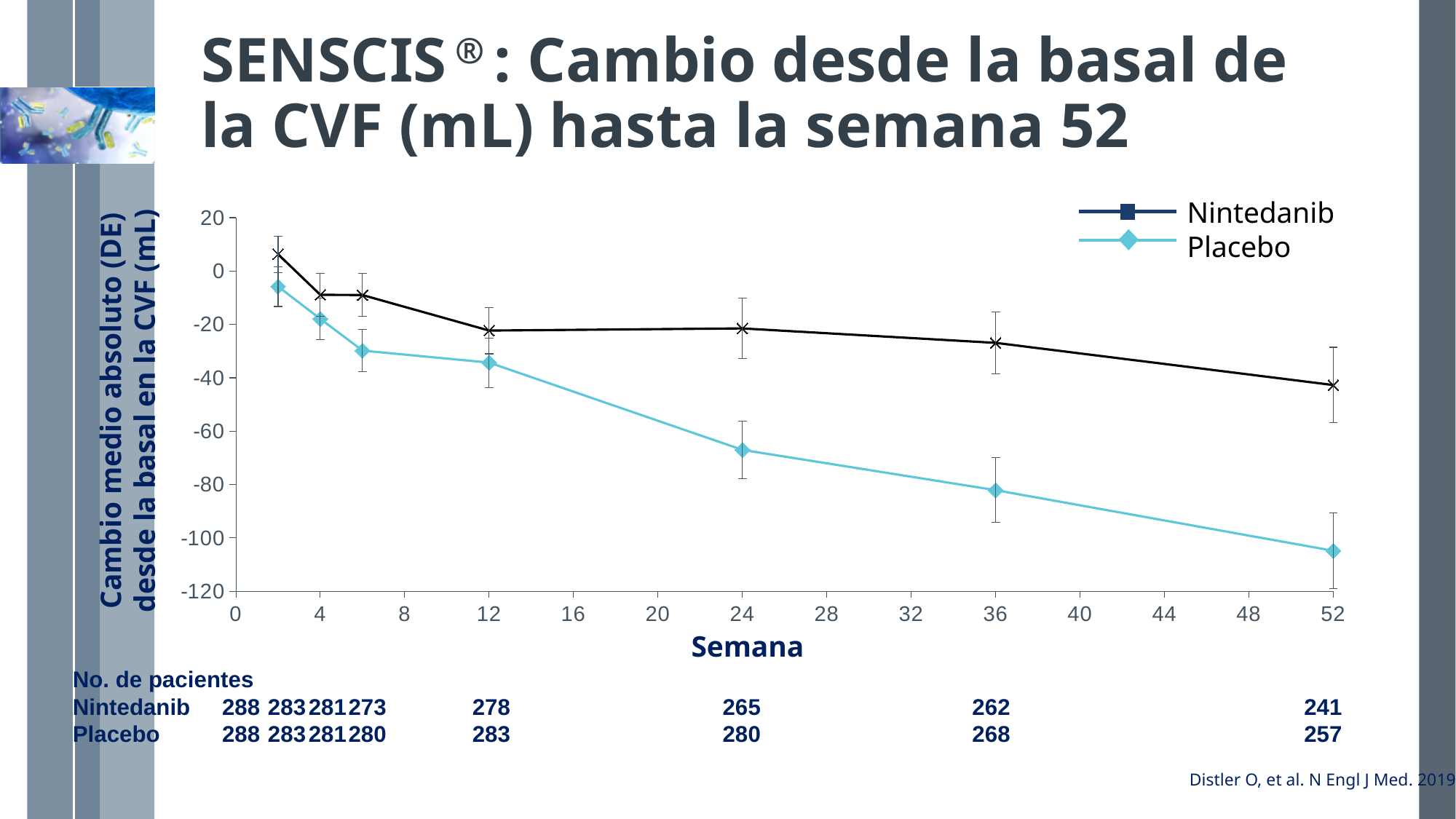
According to the patient numbers below the chart, how many Nintedanib patients were there at week 52? 241 Is the Placebo value at week 52 greater or less than -100? less Is the Placebo value at week 24 greater or less than -60? less Which two series are listed in the legend? Nintedanib and Placebo Do the Nintedanib values rise or fall from week 2 to week 52? fall At week 52, which series has the higher value, Nintedanib or Placebo? Nintedanib According to the patient numbers below the chart, how many Placebo patients were there at week 24? 280 Is the Nintedanib value at week 24 greater or less than -40? greater What is the label of the x axis? Semana How many series does the legend list? 2 Do the Placebo values rise or fall as the weeks increase? fall What kind of chart is shown on the slide? line chart